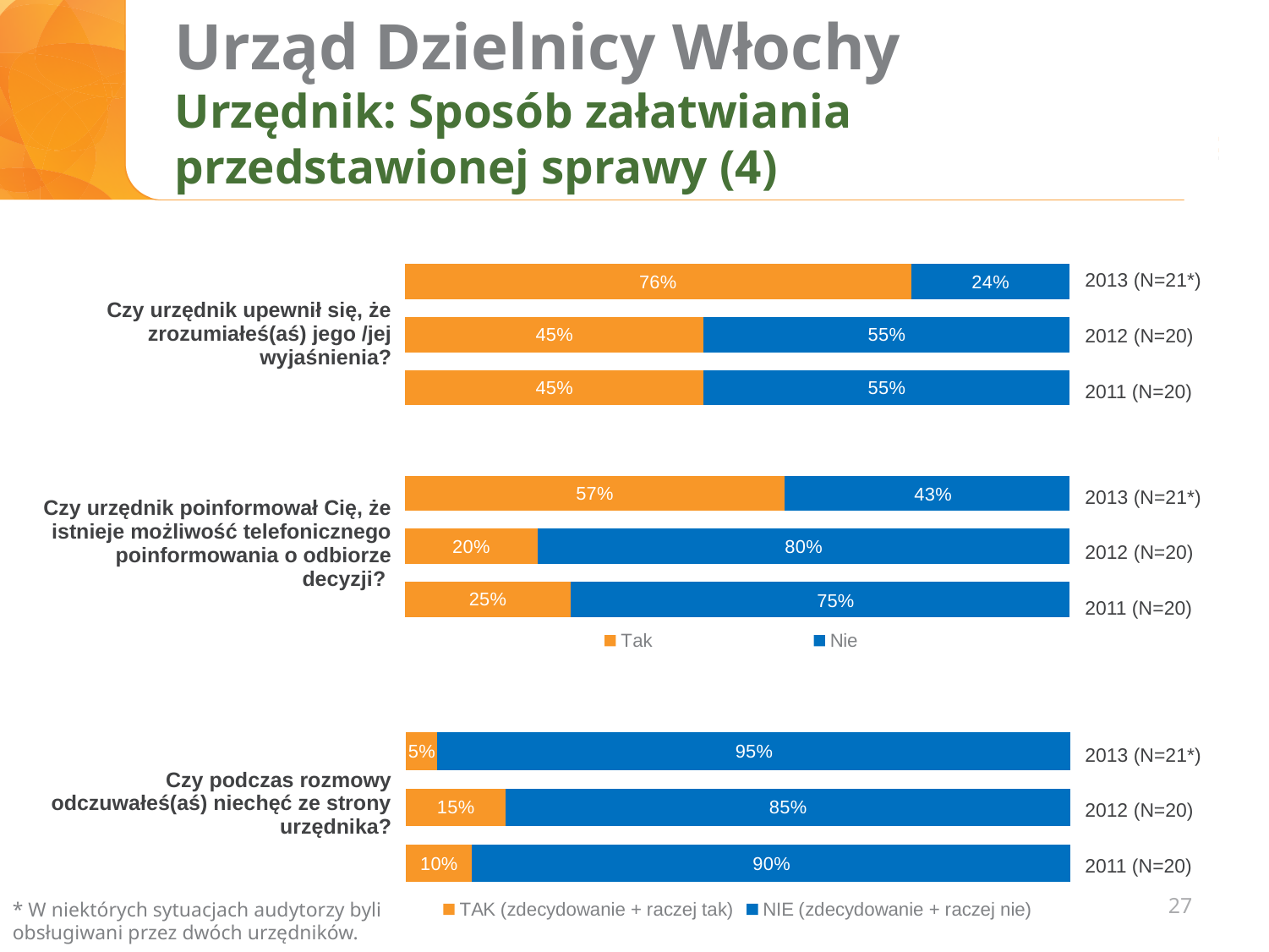
In the top chart ("Czy urzędnik upewnił się, że zrozumiałeś(aś) jego /jej wyjaśnienia?"), what is the Nie value for 2012 (N=20)? 55% In the bottom chart ("Czy podczas rozmowy odczuwałeś(aś) niechęć ze strony urzędnika?"), is the TAK value for 2011 (N=20) larger or smaller than the TAK value for 2013 (N=21*)? larger In the middle chart ("Czy urzędnik poinformował Cię, że istnieje możliwość telefonicznego poinformowania o odbiorze decyzji?"), what is the difference between the Nie values for 2012 (N=20) and 2013 (N=21*)? 37% In the bottom chart ("Czy podczas rozmowy odczuwałeś(aś) niechęć ze strony urzędnika?"), which year has the highest TAK value? 2012 (N=20) In the top chart ("Czy urzędnik upewnił się, że zrozumiałeś(aś) jego /jej wyjaśnienia?"), which year has the highest Tak value? 2013 (N=21*) In the top chart ("Czy urzędnik upewnił się, że zrozumiałeś(aś) jego /jej wyjaśnienia?"), what is the Tak value for 2013 (N=21*)? 76% What type of chart is the middle chart ("Czy urzędnik poinformował Cię, że istnieje możliwość telefonicznego poinformowania o odbiorze decyzji?")? Stacked bar chart How many series does the legend of the bottom chart ("Czy podczas rozmowy odczuwałeś(aś) niechęć ze strony urzędnika?") list? 2 In the bottom chart ("Czy podczas rozmowy odczuwałeś(aś) niechęć ze strony urzędnika?"), what is the NIE value for 2013 (N=21*)? 95% In the middle chart ("Czy urzędnik poinformował Cię, że istnieje możliwość telefonicznego poinformowania o odbiorze decyzji?"), what is the Tak value for 2012 (N=20)? 20% In the middle chart ("Czy urzędnik poinformował Cię, że istnieje możliwość telefonicznego poinformowania o odbiorze decyzji?"), which year has the lowest Tak value? 2012 (N=20) How many bars does the top chart ("Czy urzędnik upewnił się, że zrozumiałeś(aś) jego /jej wyjaśnienia?") contain? 3